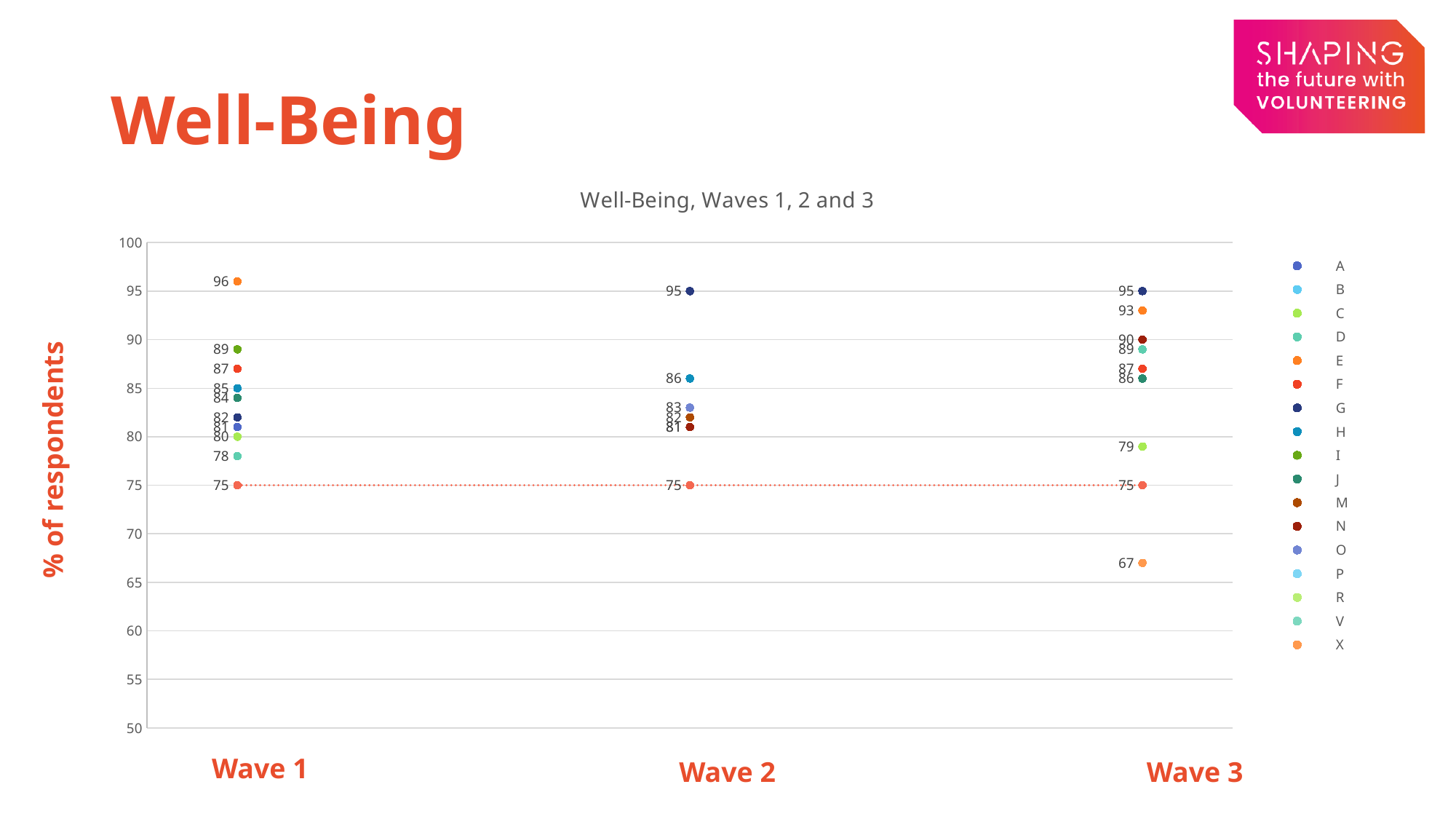
What is the title of the chart? Well-Being, Waves 1, 2 and 3 How many series does the legend list? 17 What is the lowest value plotted for Wave 3? 67 What value does the dotted horizontal line run along across all three waves? 75 Which is larger: the highest value in Wave 1 or the highest value in Wave 3? Wave 1 What is the difference between the highest value in Wave 1 and the highest value in Wave 2? 1 What is the highest value plotted for Wave 1? 96 How many waves are shown along the x axis? 3 What kind of chart is shown on the slide? Scatter (dot) chart What is the difference between the highest value in Wave 3 (95) and the lowest value in Wave 3 (67)? 28 What is the highest value plotted for Wave 2? 95